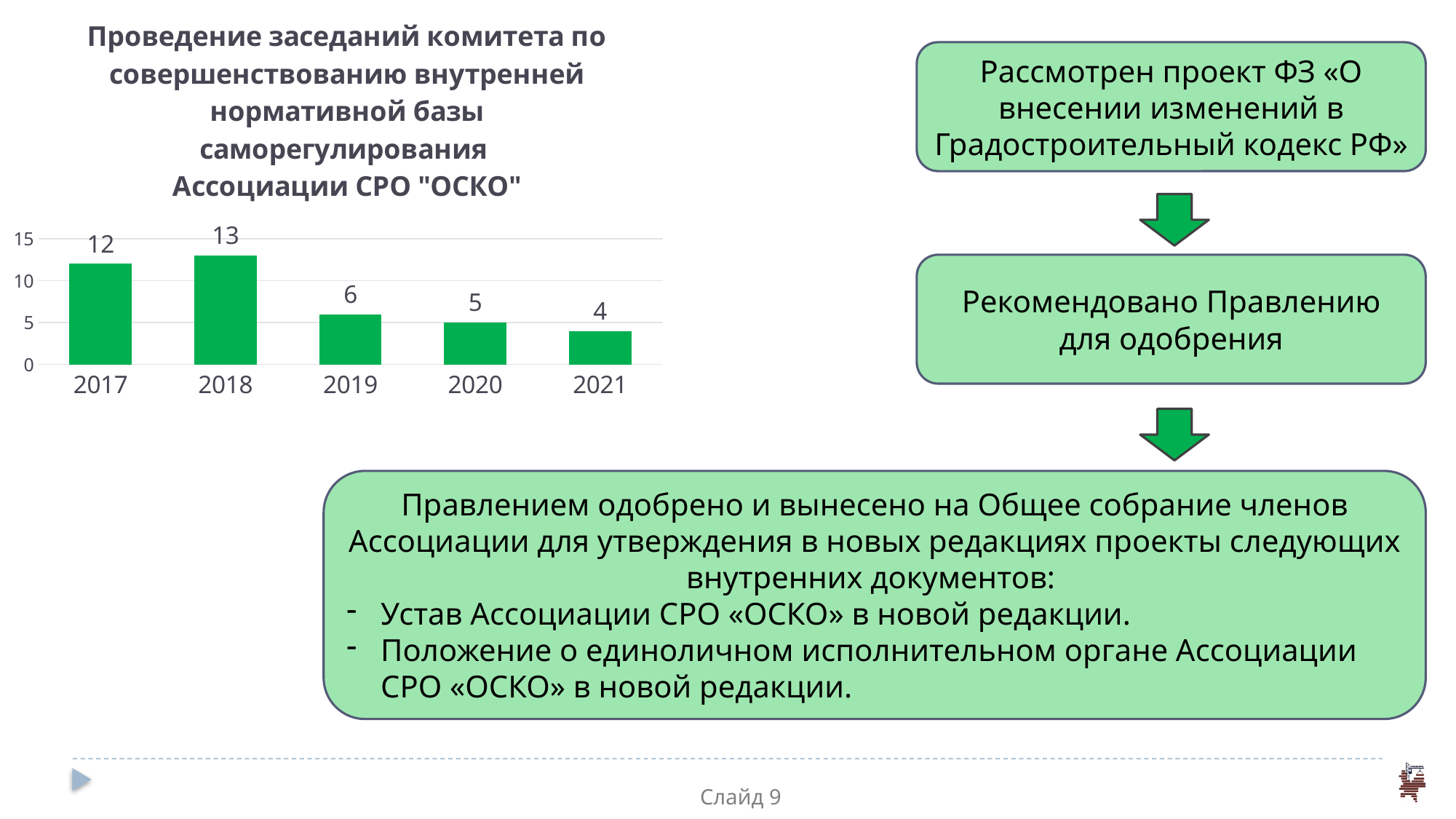
Which is larger, the value for 2019 or the value for 2020? 2019 What is the value for 2019? 6 What is the value for 2017? 12 What kind of chart is shown on the slide? bar chart What is the value for 2018? 13 How many years are shown on the x axis? 5 Is the value for 2017 greater or less than 10? greater What is the value for 2021? 4 Which year has the lowest value? 2021 Which year has the highest value? 2018 Do the values rise or fall from 2018 to 2021? fall What is the difference between the values for 2018 and 2019? 7